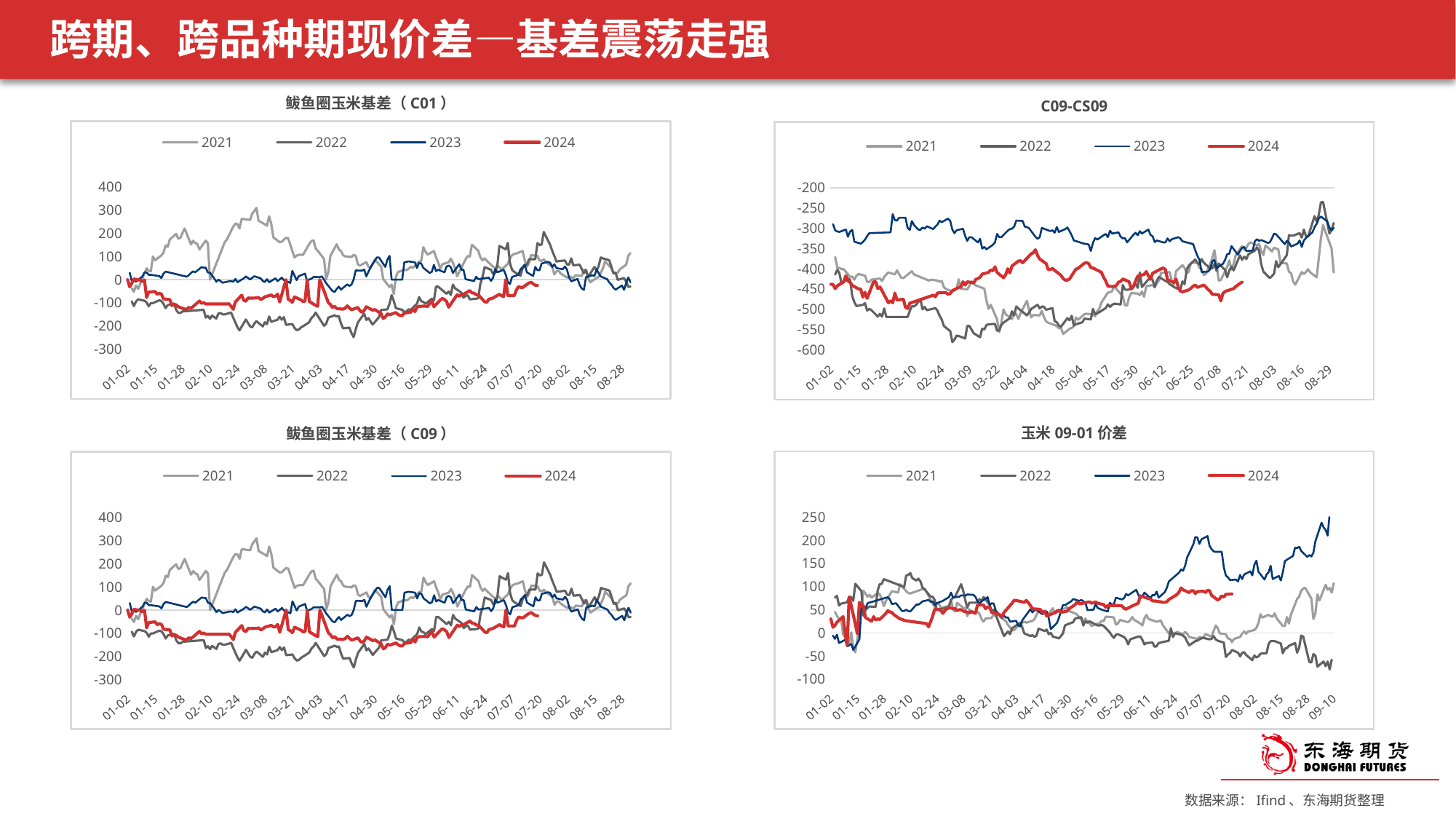
How many series does the legend of the C09-CS09 chart list? 4 What is the title of the bottom-left chart? 鲅鱼圈玉米基差（C09） In the C09-CS09 chart, around 03-09, which line is higher, 2023 or 2022? 2023 In the 玉米 09-01 价差 chart, which year is drawn in red? 2024 In the 玉米 09-01 价差 chart, at 07-20, which line is higher, 2023 or 2022? 2023 In the 鲅鱼圈玉米基差（C09）chart, is the 2022 value around 04-17 greater or less than -100? less In the C09-CS09 chart, is the 2023 value at 01-02 greater or less than -400? greater In the 玉米 09-01 价差 chart, is the 2023 value at 09-10 greater or less than 200? greater In the 玉米 09-01 价差 chart, does the 2023 line rise or fall from 06-11 to 09-10? rise What type of chart is the top-left chart titled 鲅鱼圈玉米基差（C01）? line chart